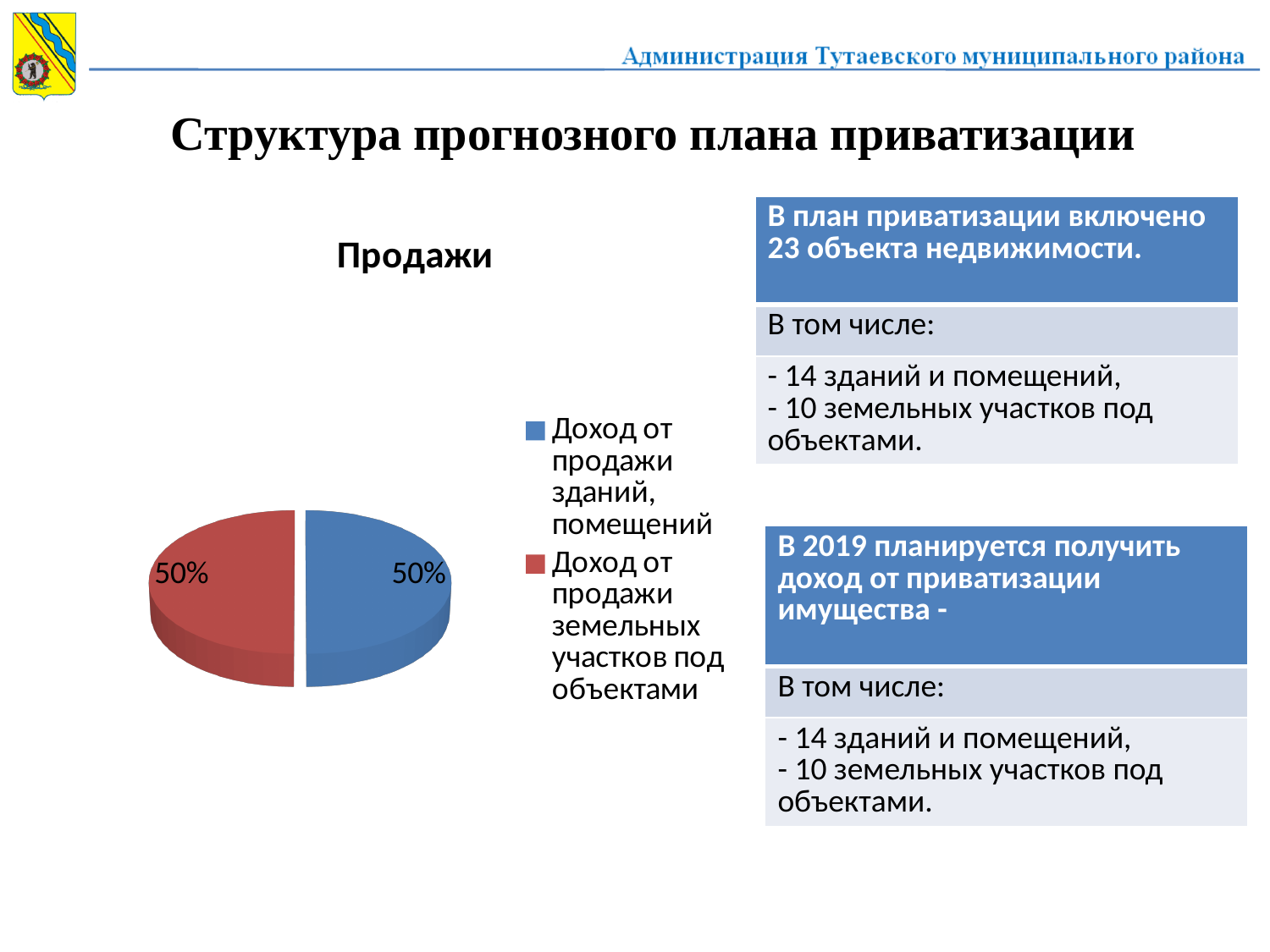
What is the title of the chart on the slide? Продажи What share of the pie does "Доход от продажи зданий, помещений" take? 50% How many slices does the pie chart have? 2 Is the share of "Доход от продажи зданий, помещений" greater or less than 40%? greater What kind of chart is shown under the title "Продажи"? pie chart What share of the pie does "Доход от продажи земельных участков под объектами" take? 50% Which colour represents "Доход от продажи земельных участков под объектами" in the pie chart? red What is the difference between the shares of the two slices in the pie chart? 0% What value is labelled on the blue slice of the pie chart? 50% What do the two slices of the pie chart add up to? 100% How many entries does the legend of the pie chart list? 2 What value is labelled on the red slice of the pie chart? 50%